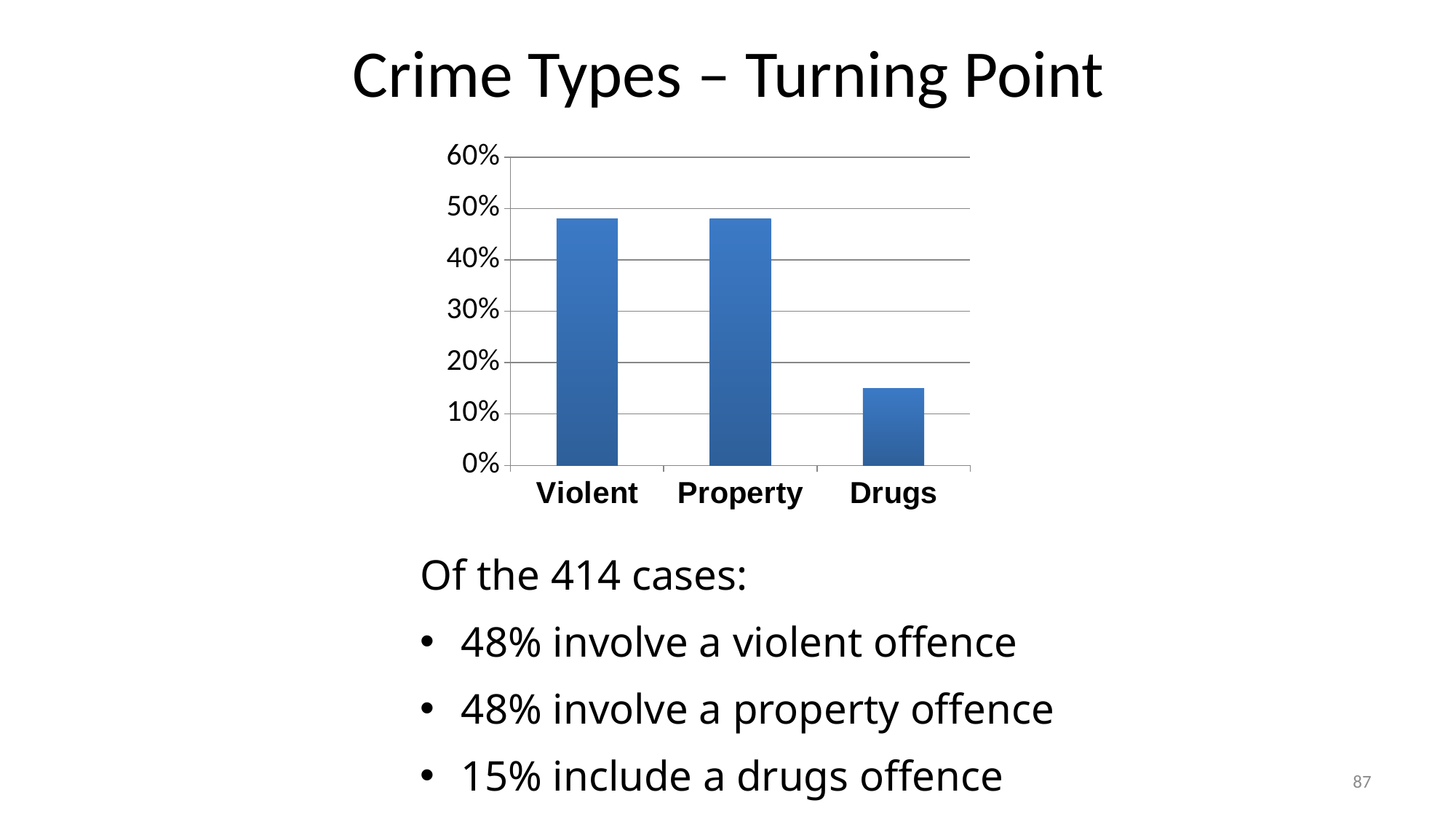
Is the value for Drugs greater or less than 20%? less What is the highest value shown on the vertical axis? 60% What is the value for Violent? 48% Is the value for Violent greater or less than 50%? less How many crime type categories are shown on the chart? 3 Which category has the lowest value? Drugs What is the value for Drugs? 15% What type of chart is shown on the slide? bar chart What is the title of the slide containing the chart? Crime Types – Turning Point Which is larger, the value for Property or the value for Drugs? Property What is the value for Property? 48% What is the difference between the value for Violent and the value for Drugs? 33 percentage points